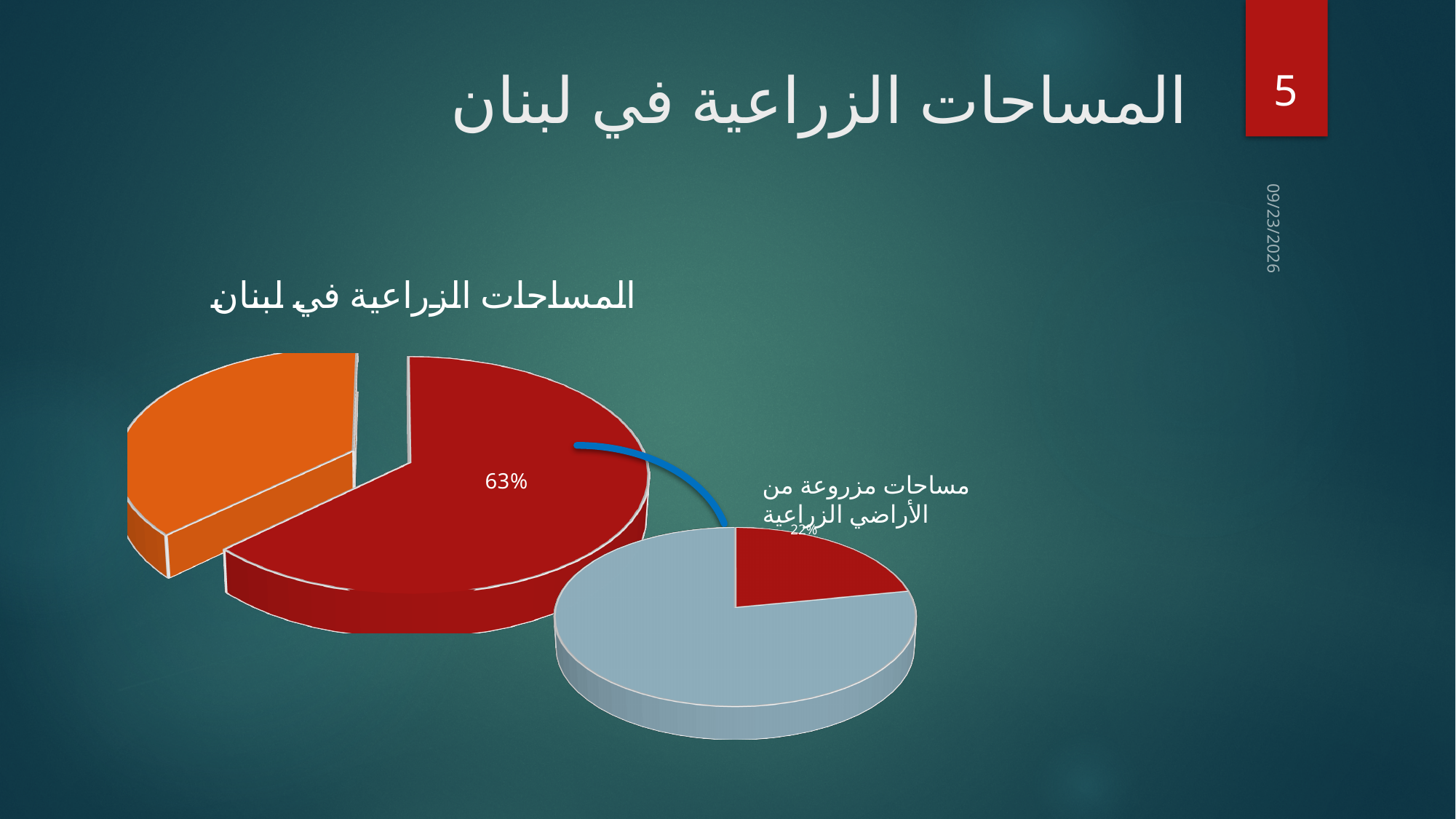
Which slice of the main pie is the largest? The red slice (63%) What kind of chart is shown on the slide? Pie chart What percentage is printed on the red slice of the smaller secondary pie? 22% How many slices does the main pie have? 2 What is the title of the chart? المساحات الزراعية في لبنان In the smaller secondary pie, which slice is larger, the red one or the light blue one? The light blue one What share of the main pie does the red slice represent? 63% What text label is shown next to the smaller secondary pie? مساحات مزروعة من الأراضي الزراعية In the main pie, which slice is larger, the red one or the orange one? The red one What percentage is printed on the red slice of the main pie? 63%